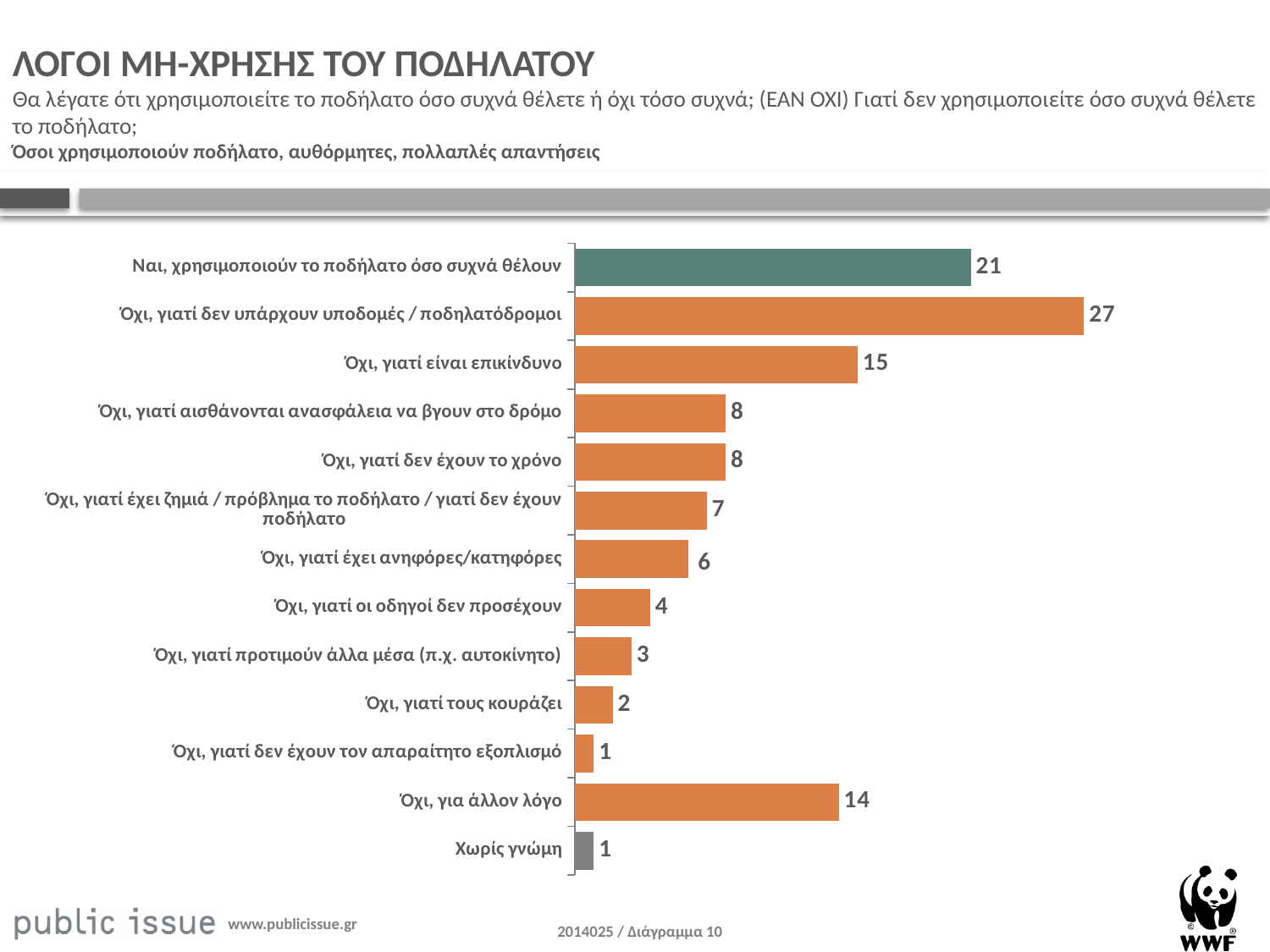
What is the value for 'Όχι, γιατί δεν υπάρχουν υποδομές / ποδηλατόδρομοι'? 27 What is the difference between the values for 'Όχι, γιατί είναι επικίνδυνο' and 'Όχι, γιατί οι οδηγοί δεν προσέχουν'? 11 How many categories are shown in the chart? 13 What is the value for 'Όχι, γιατί είναι επικίνδυνο'? 15 What is the value for 'Όχι, για άλλον λόγο'? 14 Which is larger: the value for 'Όχι, γιατί έχει ανηφόρες/κατηφόρες' or the value for 'Όχι, γιατί προτιμούν άλλα μέσα (π.χ. αυτοκίνητο)'? Όχι, γιατί έχει ανηφόρες/κατηφόρες Which category has the highest value? Όχι, γιατί δεν υπάρχουν υποδομές / ποδηλατόδρομοι What type of chart is shown on the slide? Bar chart What is the title of the slide? ΛΟΓΟΙ ΜΗ-ΧΡΗΣΗΣ ΤΟΥ ΠΟΔΗΛΑΤΟΥ What is the difference between the values for 'Όχι, γιατί δεν υπάρχουν υποδομές / ποδηλατόδρομοι' and 'Ναι, χρησιμοποιούν το ποδήλατο όσο συχνά θέλουν'? 6 What is the value for 'Ναι, χρησιμοποιούν το ποδήλατο όσο συχνά θέλουν'? 21 What is the value for 'Όχι, γιατί τους κουράζει'? 2